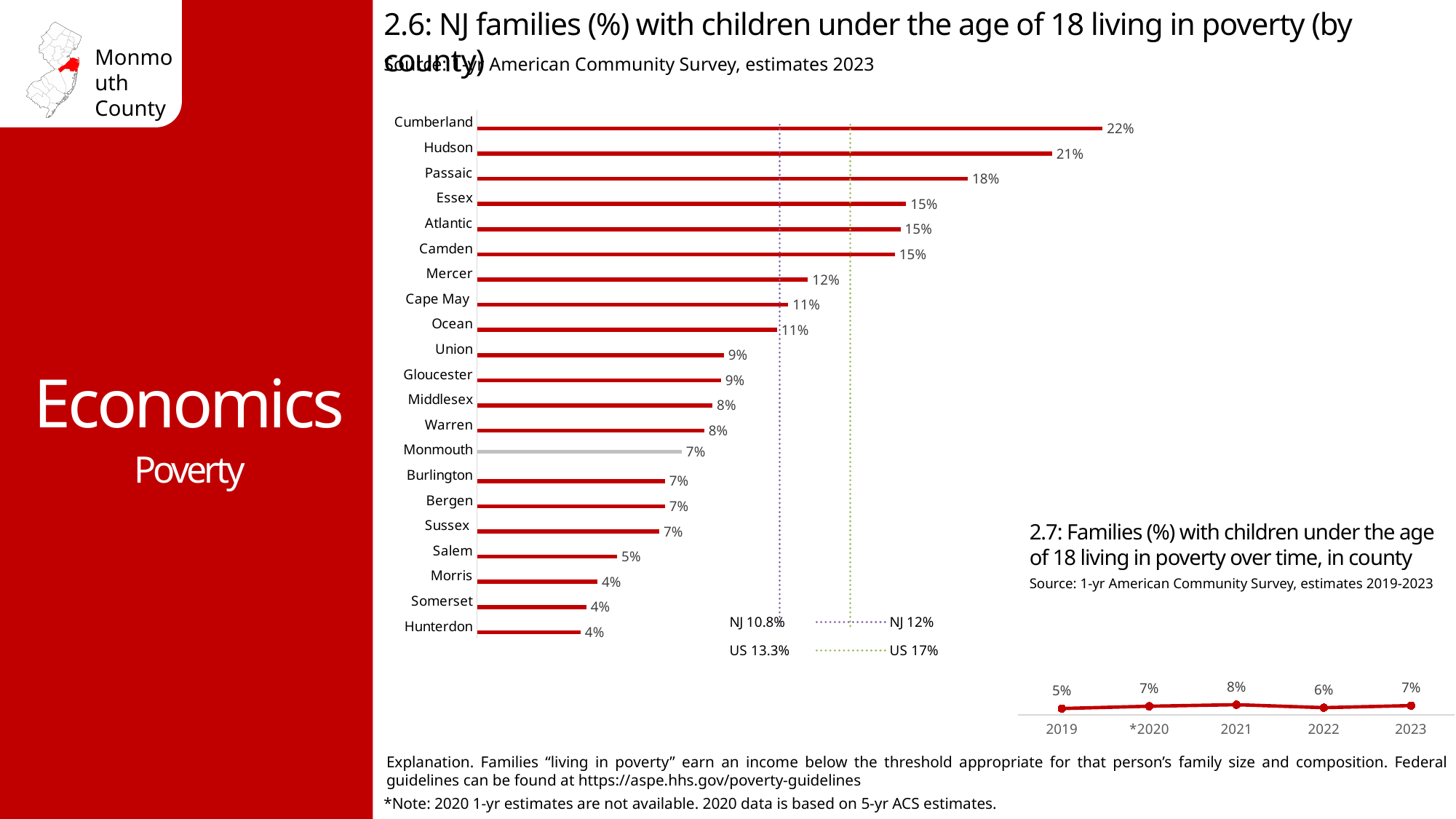
What kind of chart is chart 2.6 (NJ families with children under 18 living in poverty by county)? Bar chart In chart 2.7 (over time, in county), which year has the lowest value? 2019 In chart 2.7 (families with children under 18 living in poverty over time, in county), what is the value for 2021? 8% In chart 2.6 (NJ families with children under 18 living in poverty by county), what is the value for Monmouth? 7% In chart 2.6 (by county), how many counties are plotted? 21 In chart 2.6 (by county), which county has the highest percentage of families with children living in poverty? Cumberland In chart 2.6 (by county), which is larger, the value for Mercer or the value for Union? Mercer In chart 2.6 (by county), what is the value for Salem? 5% In chart 2.7 (over time, in county), how many years are plotted? 5 In chart 2.6 (by county), what is the difference between the values for Cumberland and Passaic? 4% In chart 2.6 (by county), what is the value for Hudson? 21%